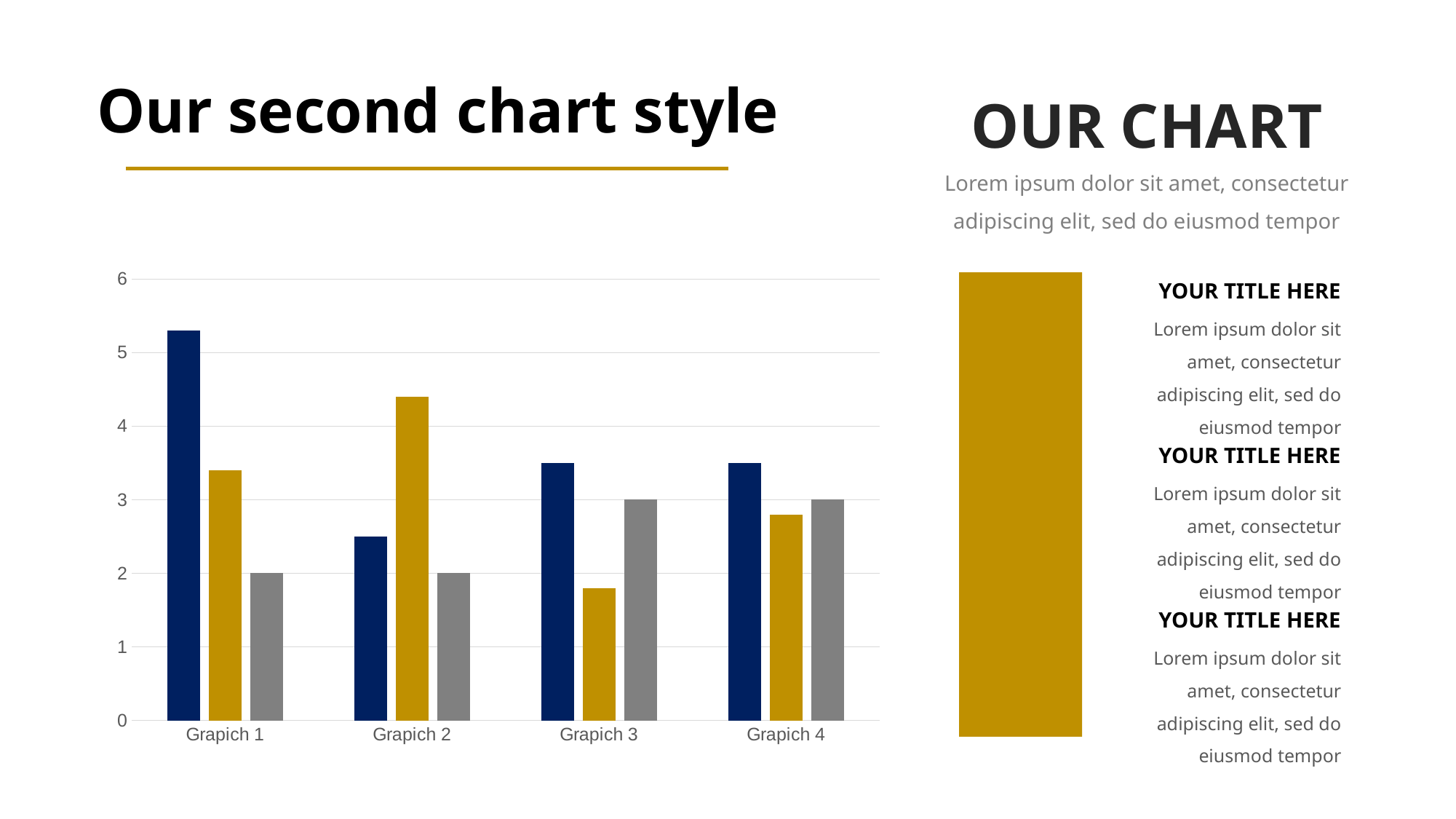
Is the value of the navy bar for Grapich 2 greater or less than 3? less Which category has the tallest navy bar? Grapich 1 Is the value of the gold bar for Grapich 2 greater or less than 4? greater How many categories are shown on the x axis of the chart? 4 Is the value of the gold bar for Grapich 3 greater or less than 2? less Which category has the shortest gold bar? Grapich 3 What kind of chart is shown on the slide? bar chart What is the value of the gray bar for Grapich 1? 2 What is the value of the gray bar for Grapich 4? 3 What is the value of the gray bar for Grapich 3? 3 Which is larger for Grapich 2, the navy bar or the gold bar? the gold bar